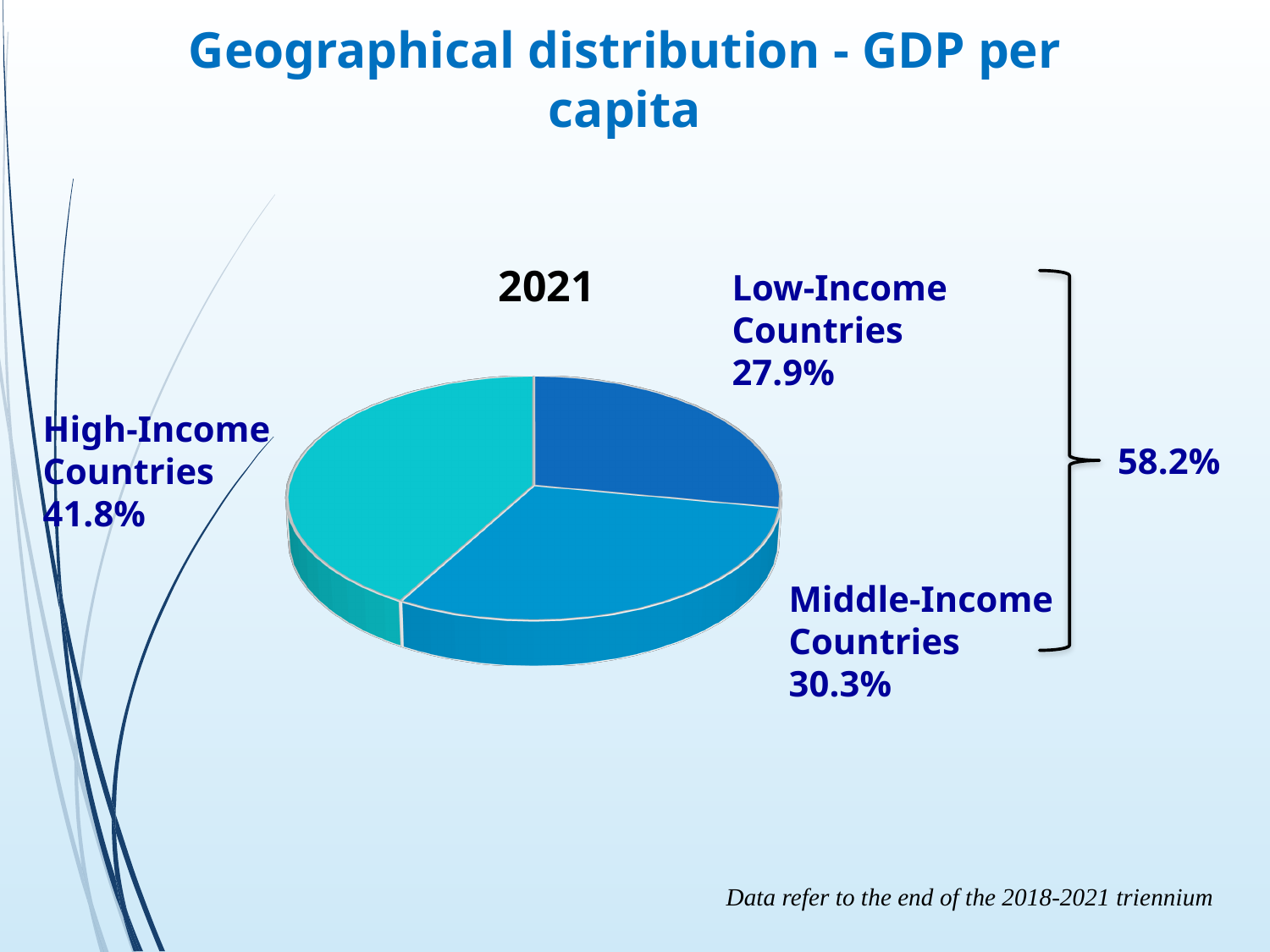
Which category has the smallest slice of the pie? Low-Income Countries Which is larger, the share for Middle-Income Countries or the share for Low-Income Countries? Middle-Income Countries What is the difference between the Middle-Income Countries share and the Low-Income Countries share? 2.4% How many slices does the pie chart have? 3 What share of the pie do High-Income Countries hold? 41.8% What share of the pie do Middle-Income Countries hold? 30.3% What combined share do Low-Income and Middle-Income Countries hold together, as shown by the bracket? 58.2% What share of the pie do Low-Income Countries hold? 27.9% Which category has the largest slice of the pie? High-Income Countries What is the difference between the High-Income Countries share and the Low-Income Countries share? 13.9% Which year is labelled on the pie chart? 2021 What kind of chart is shown on the slide? Pie chart